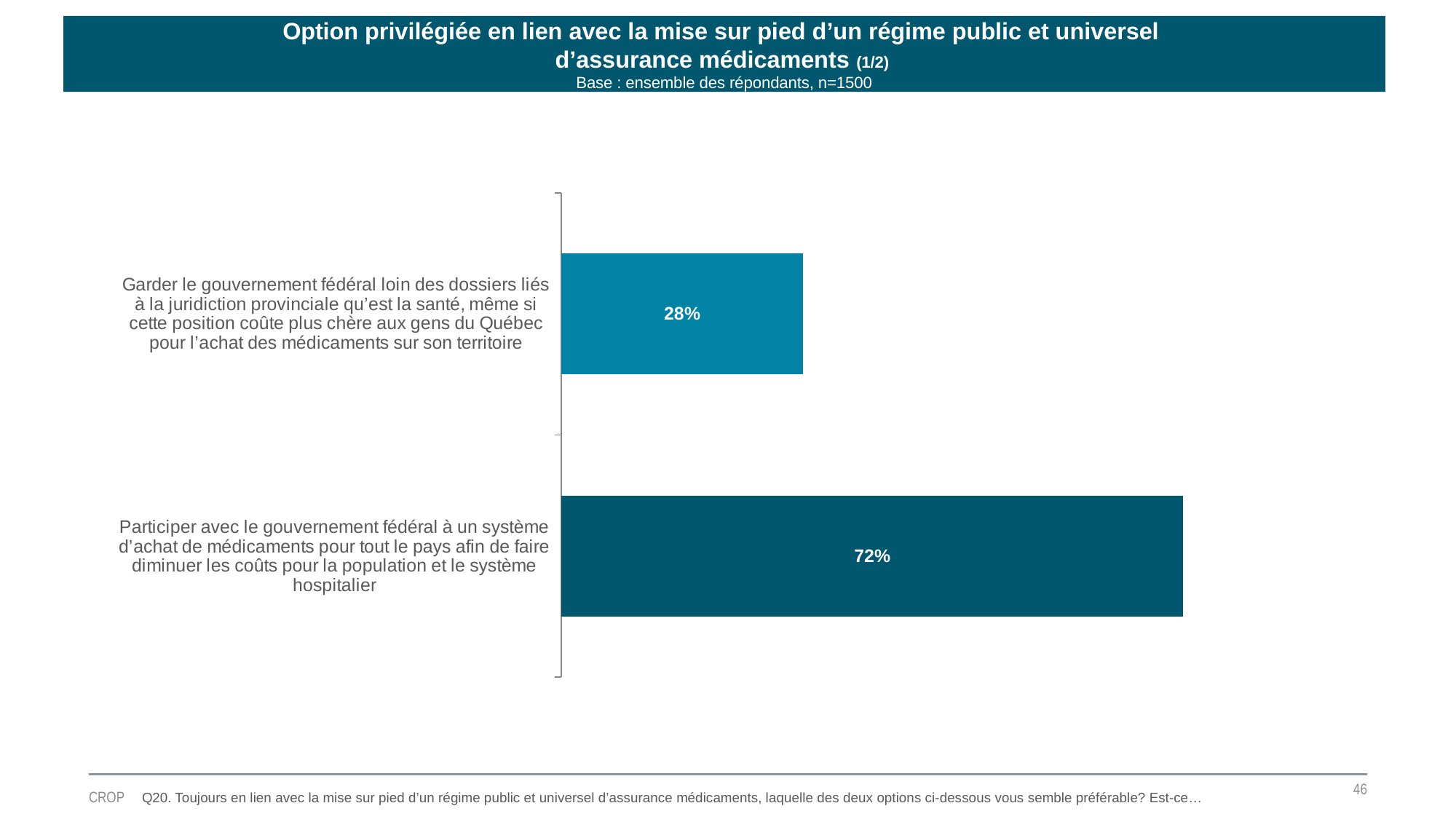
What is the difference in percentage points between the two options shown? 44 percentage points How many options (categories) are plotted in the chart? 2 What type of chart is shown on the slide? Bar chart What percentage of respondents chose the option 'Garder le gouvernement fédéral loin des dossiers liés à la juridiction provinciale...'? 28% Which option received the highest share of respondents? Participer avec le gouvernement fédéral à un système d'achat de médicaments pour tout le pays afin de faire diminuer les coûts pour la population et le système hospitalier What is the total of the two percentages shown in the chart? 100% Which survey question number is referenced at the bottom of the slide? Q20 What percentage of respondents chose the option 'Participer avec le gouvernement fédéral à un système d'achat de médicaments pour tout le pays...'? 72% Which is larger: the share for 'Participer avec le gouvernement fédéral...' or the share for 'Garder le gouvernement fédéral loin...'? Participer avec le gouvernement fédéral... What is the base (number of respondents) stated under the chart title? n=1500